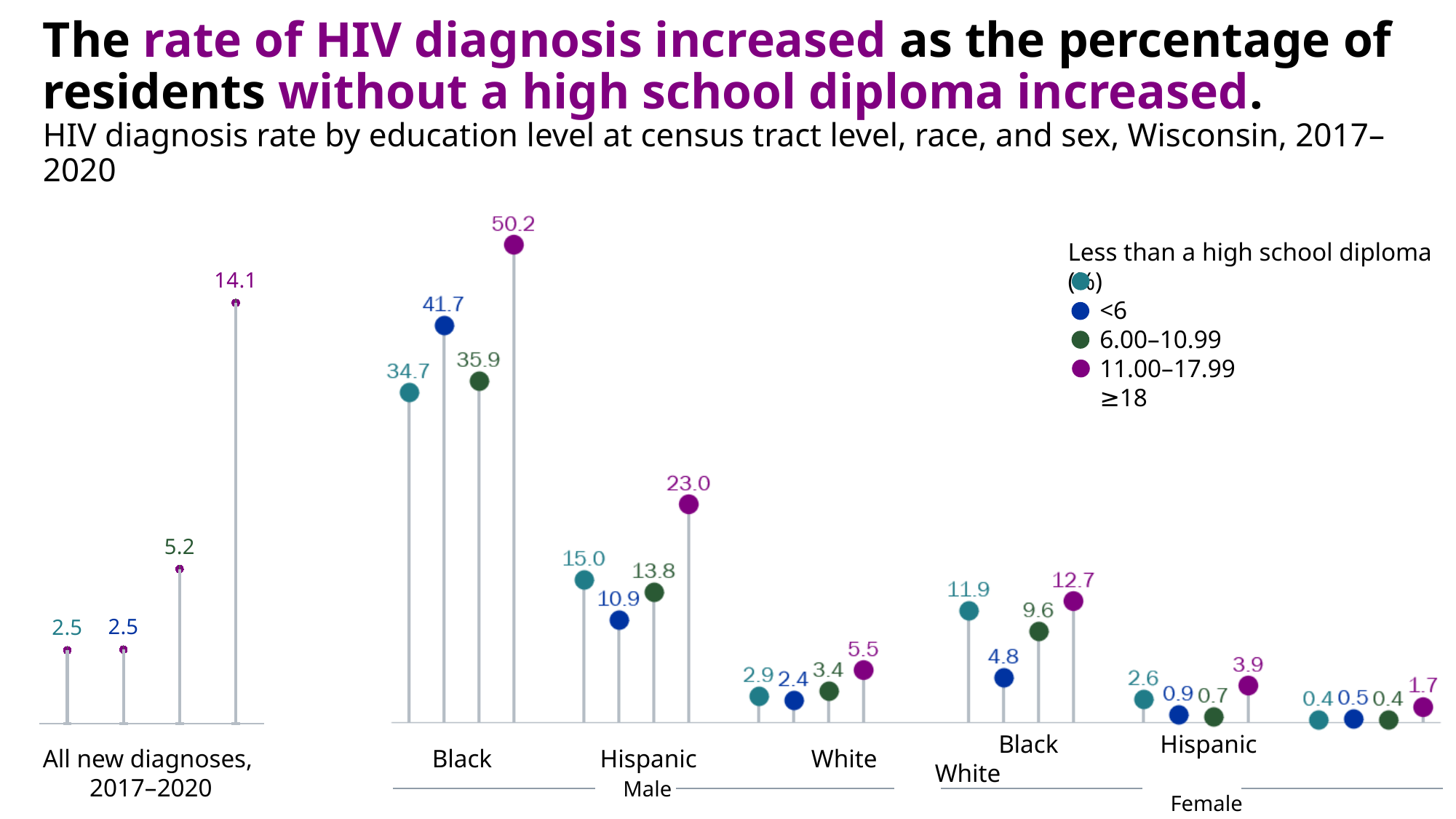
What is the difference between the purple marker (23.0) and the green marker (13.8) for Hispanic males? 9.2 Which marker has the lowest value within the Black male group? The teal marker (34.7) What is the value of the green marker for Black females? 9.6 Moving left to right across the four markers in the 'All new diagnoses, 2017–2020' group, do the values rise or fall? Rise What is the value of the purple marker for Hispanic males? 23.0 What is the value of the purple marker for Black males? 50.2 What is the difference between the purple marker (50.2) and the teal marker (34.7) for Black males? 15.5 What is the value of the purple marker in the 'All new diagnoses, 2017–2020' group? 14.1 Which is larger: the teal marker for Hispanic males or the teal marker for Black females? Hispanic males (15.0) How many markers are plotted in each race/sex group? 4 What is the value of the blue marker for Hispanic males? 10.9 What is the highest value shown anywhere on the chart? 50.2